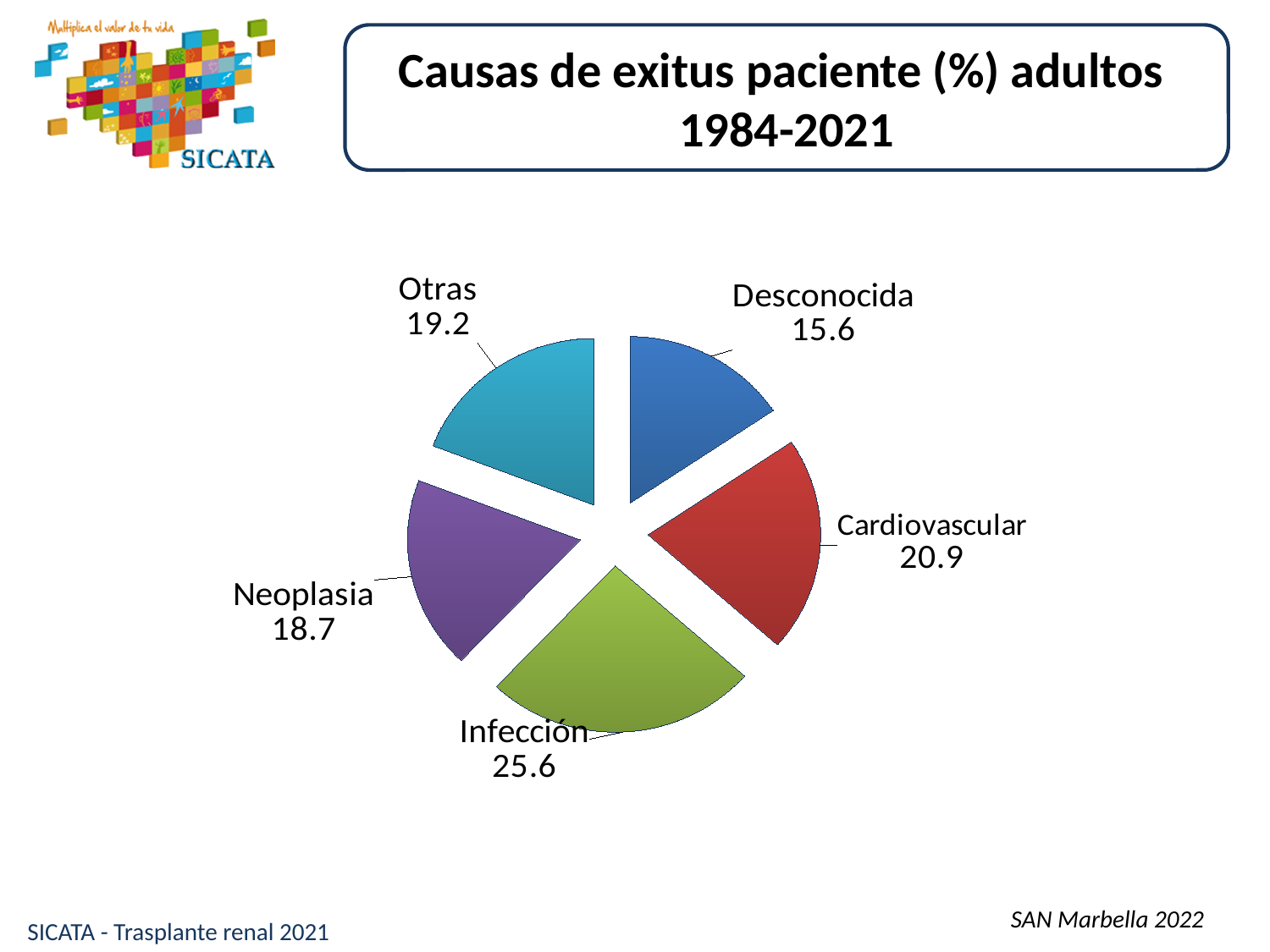
How many slices does the pie chart have? 5 What is the value for Desconocida? 15.6 What is the value for Infección? 25.6 Which is larger, Otras or Neoplasia? Otras Which cause has the largest slice? Infección Which cause has the smallest slice? Desconocida What is the title of the chart? Causas de exitus paciente (%) adultos 1984-2021 What is the difference between the values for Infección and Desconocida? 10.0 What is the value for Neoplasia? 18.7 What kind of chart is shown on the slide? Pie chart What is the value for Cardiovascular? 20.9 What is the difference between the values for Cardiovascular and Neoplasia? 2.2